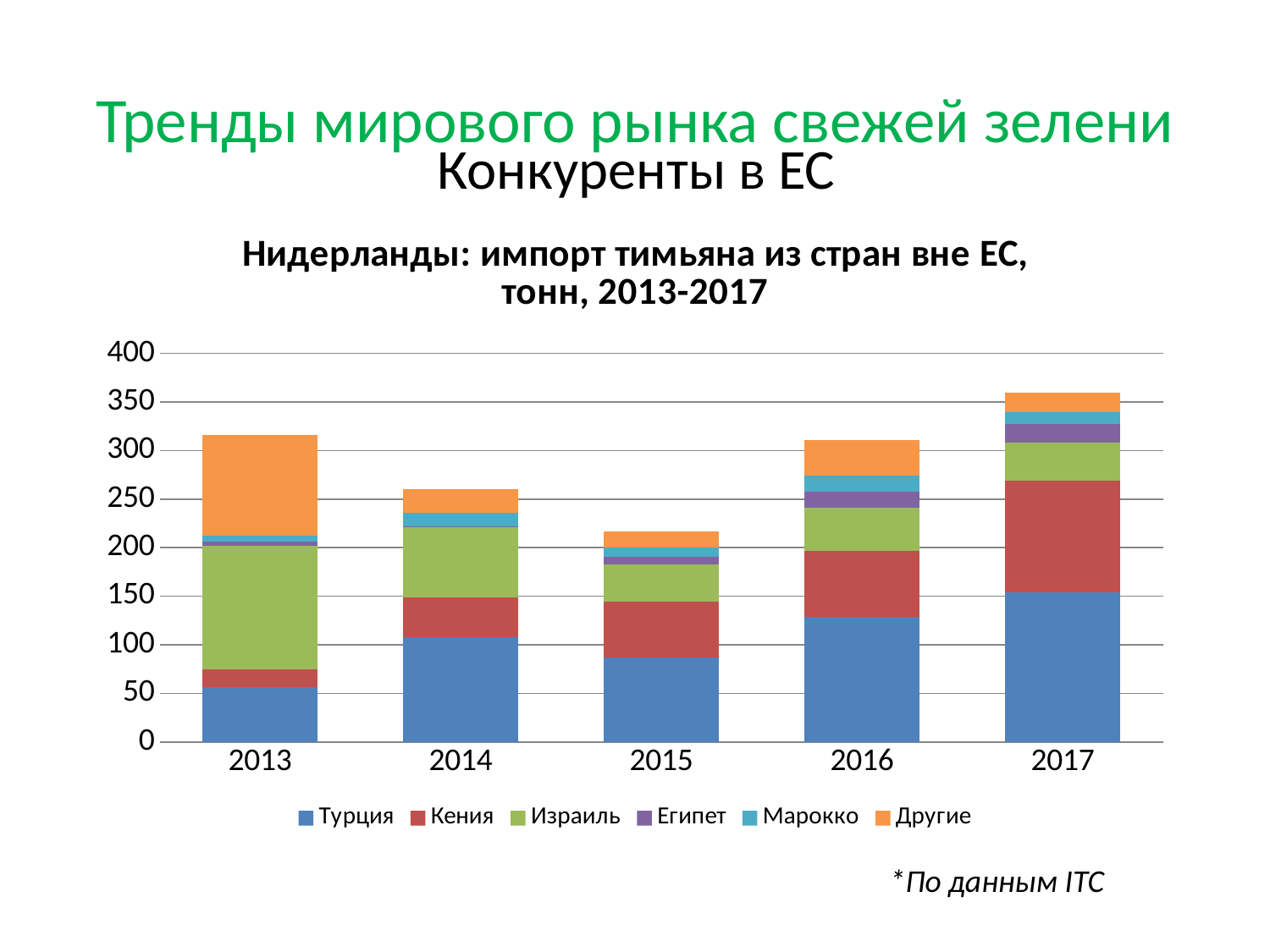
From 2015 to 2017, do the total bar heights rise or fall? rise Is the total height of the 2015 bar greater or less than 250? less Which year has the shortest stacked bar (smallest total import)? 2015 Which series is shown at the bottom of each stacked bar? Турция Is the total height of the 2017 bar greater or less than 350? greater Which is larger: the Турция segment in 2017 or the Турция segment in 2013? 2017 What kind of chart is shown on the slide? Stacked bar chart Which year has the tallest stacked bar (largest total import)? 2017 How many years are shown on the x axis of the chart? 5 How many series does the chart legend list? 6 Which is larger: the Израиль segment in 2013 or the Израиль segment in 2017? 2013 Is the value for Турция in 2013 greater or less than 100? less